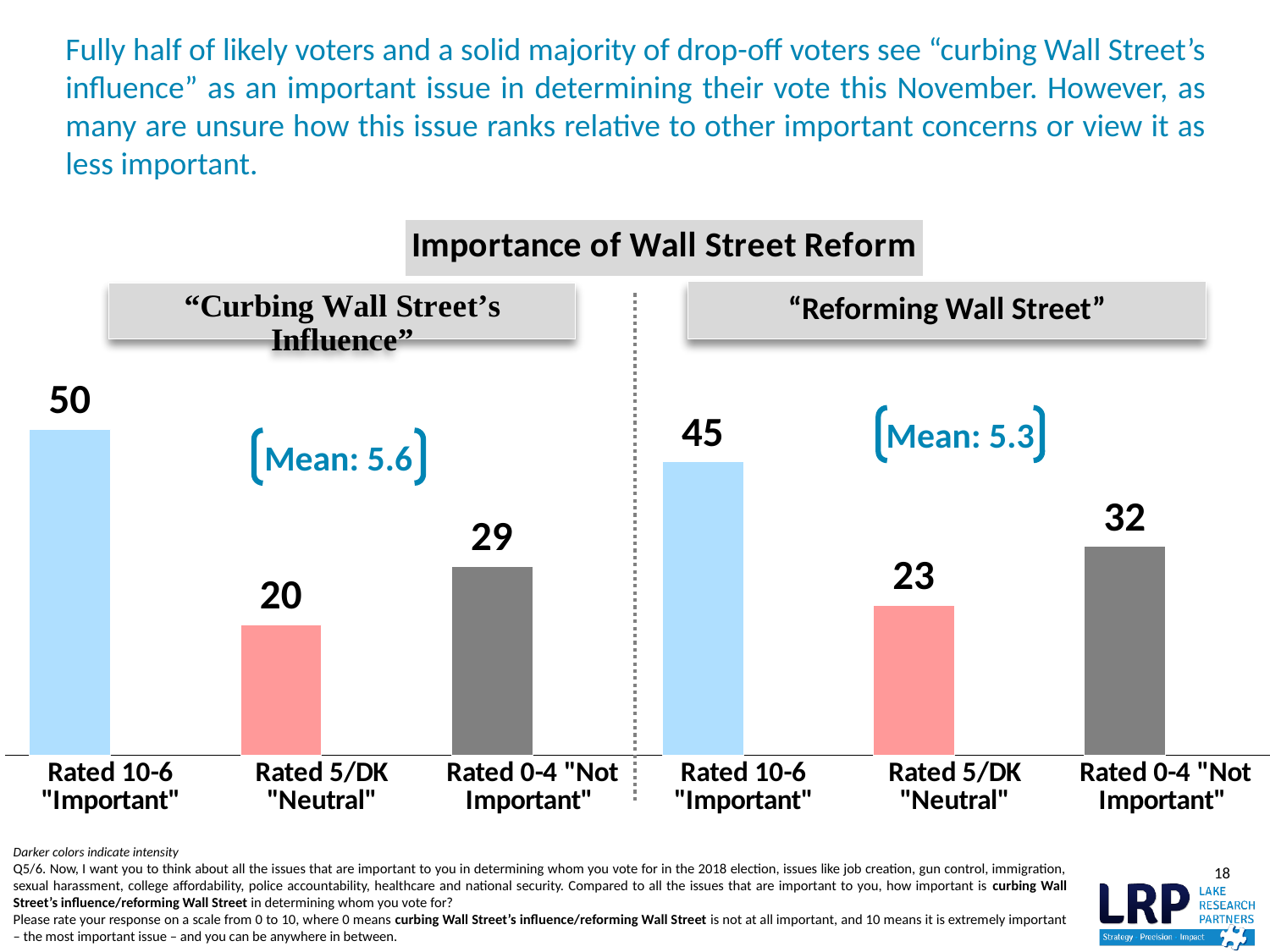
In the "Reforming Wall Street" chart, what is the difference between Rated 10-6 "Important" and Rated 5/DK "Neutral"? 22 In the "Reforming Wall Street" chart, which category has the highest value? Rated 10-6 "Important" What mean is shown for the "Curbing Wall Street's Influence" chart? Mean: 5.6 What kind of chart is used for "Reforming Wall Street"? Bar chart In the "Curbing Wall Street's Influence" chart, what is the difference between Rated 10-6 "Important" and Rated 0-4 "Not Important"? 21 In the "Curbing Wall Street's Influence" chart, which category has the lowest value? Rated 5/DK "Neutral" How many categories are shown in the "Curbing Wall Street's Influence" chart? 3 What is the overall title above the two charts? Importance of Wall Street Reform In the "Curbing Wall Street's Influence" chart, what is the value for Rated 10-6 "Important"? 50 In the "Reforming Wall Street" chart, what is the value for Rated 0-4 "Not Important"? 32 In the "Reforming Wall Street" chart, what is the value for Rated 5/DK "Neutral"? 23 Which is larger: Rated 0-4 "Not Important" in the "Curbing Wall Street's Influence" chart or Rated 0-4 "Not Important" in the "Reforming Wall Street" chart? "Reforming Wall Street"